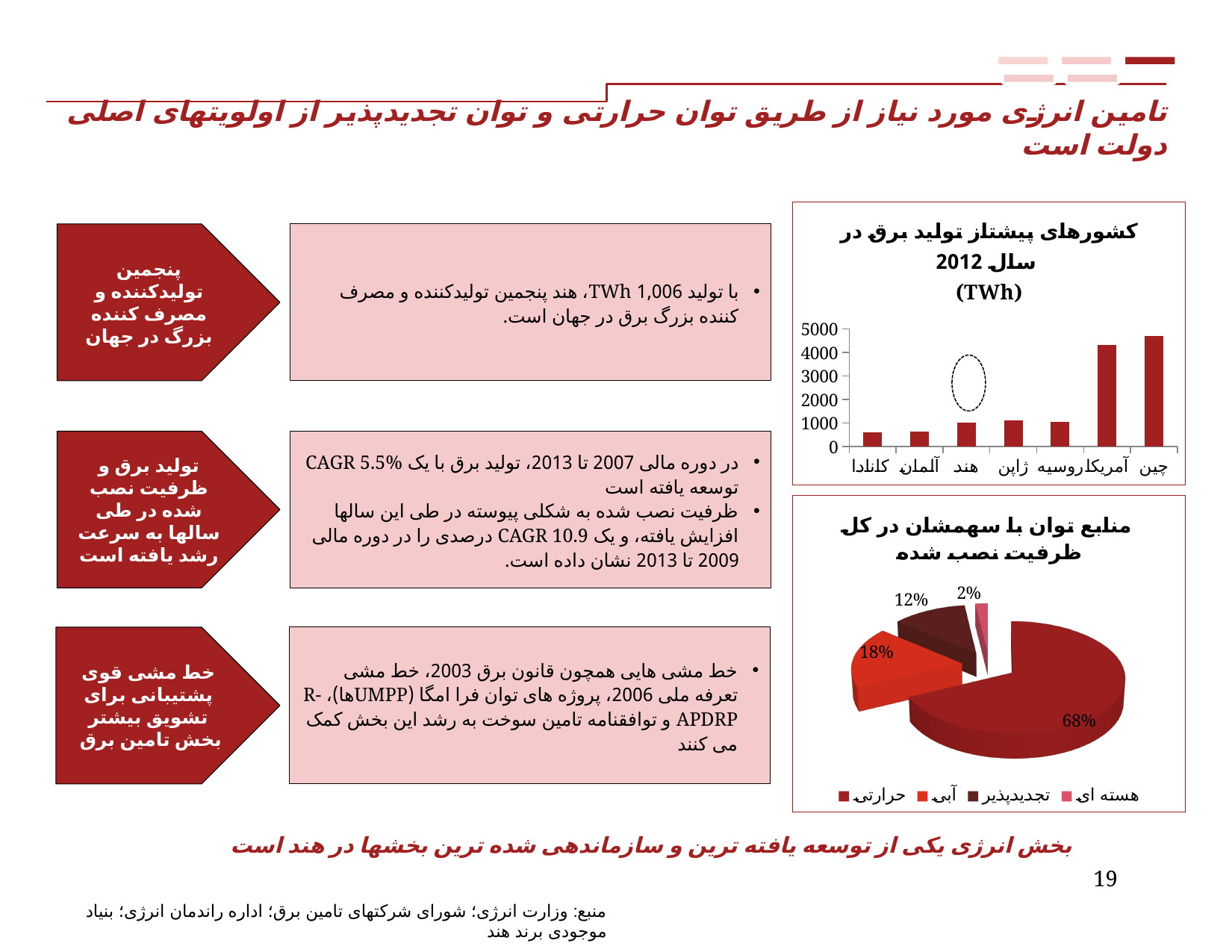
What kind of chart is the chart titled 'کشورهای پیشتاز تولید برق در سال 2012 (TWh)'? bar chart In the bar chart 'کشورهای پیشتاز تولید برق در سال 2012 (TWh)', which has a larger value, آمریکا or روسیه? آمریکا How many countries are shown in the bar chart 'کشورهای پیشتاز تولید برق در سال 2012 (TWh)'? 7 In the pie chart 'منابع توان با سهمشان در کل ظرفیت نصب شده', what is the value for آبی? 18% In the bar chart 'کشورهای پیشتاز تولید برق در سال 2012 (TWh)', which country has the highest value? چین In the pie chart 'منابع توان با سهمشان در کل ظرفیت نصب شده', what share does حرارتی have? 68% In the bar chart 'کشورهای پیشتاز تولید برق در سال 2012 (TWh)', is the value for کانادا greater or less than 1000? less In the pie chart 'منابع توان با سهمشان در کل ظرفیت نصب شده', what is the difference between the shares of آبی and تجدیدپذیر? 6% In the pie chart 'منابع توان با سهمشان در کل ظرفیت نصب شده', which source has the smallest share? هسته ای In the bar chart 'کشورهای پیشتاز تولید برق در سال 2012 (TWh)', is the value for هند greater or less than 2000? less In the bar chart 'کشورهای پیشتاز تولید برق در سال 2012 (TWh)', is the value for چین greater or less than 4000? greater What kind of chart is the chart titled 'منابع توان با سهمشان در کل ظرفیت نصب شده'? pie chart